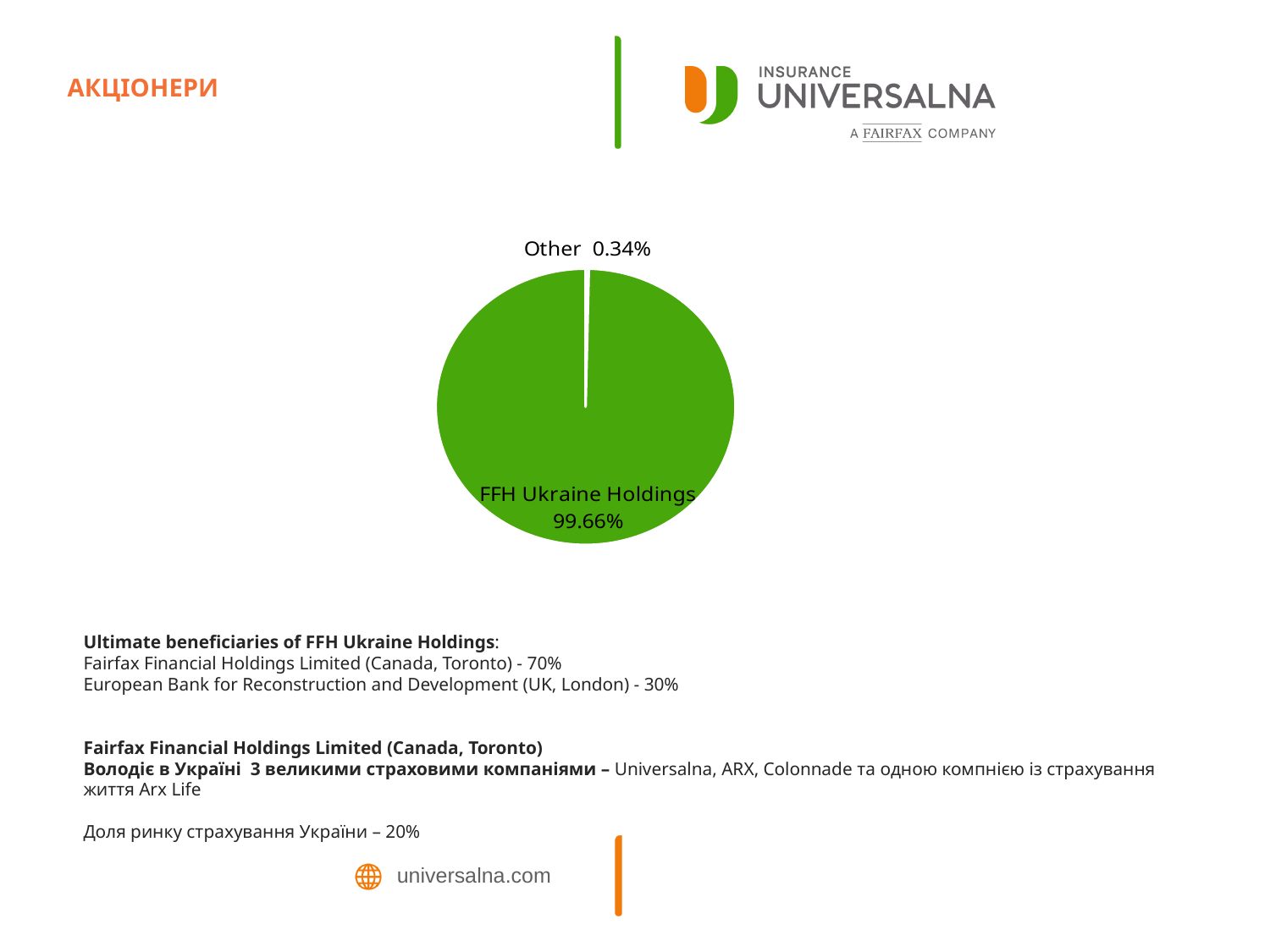
Which slice of the pie is the largest? FFH Ukraine Holdings What share of the pie does Other hold? 0.34% What is the difference between the FFH Ukraine Holdings share and the Other share? 99.32% Which is larger, the share for FFH Ukraine Holdings or the share for Other? FFH Ukraine Holdings What is the title of the slide containing the pie chart? АКЦІОНЕРИ Which slice of the pie is the smallest? Other How many slices does the pie chart have? 2 What colour is the FFH Ukraine Holdings slice? green What share of the pie does FFH Ukraine Holdings hold? 99.66% What kind of chart is shown on the slide? pie chart